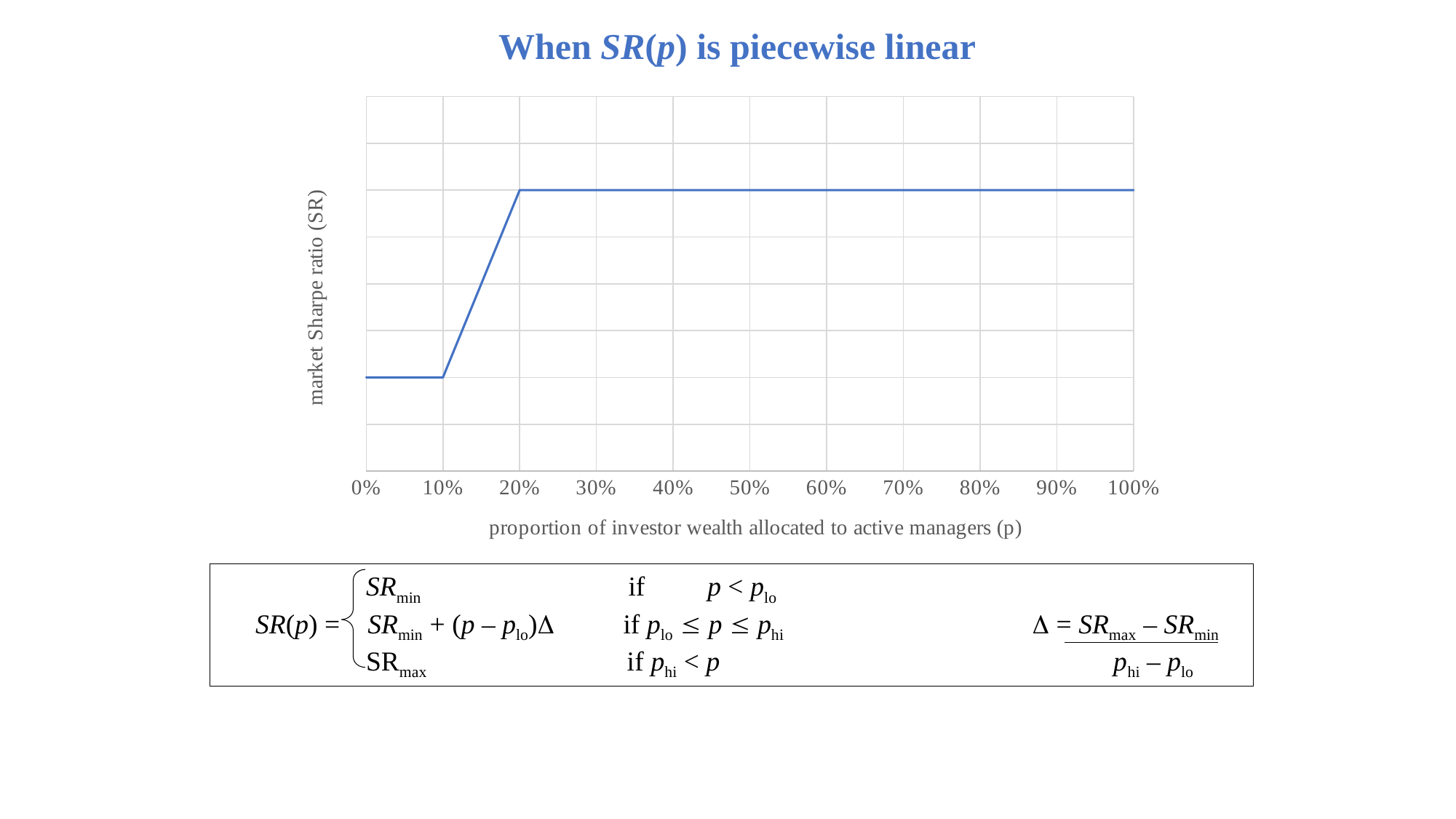
Between 10% and 20% on the x axis, does the line rise, fall, or stay flat? rise At which x-axis tick does the line begin to rise from its minimum level? 10% Is the market Sharpe ratio higher at p = 50% or at p = 5%? 50% Between 0% and 10% on the x axis, does the line rise, fall, or stay flat? stay flat What kind of chart is shown on the slide? line chart Between 20% and 100% on the x axis, does the line rise, fall, or stay flat? stay flat Is the market Sharpe ratio higher at p = 0% or at p = 100%? 100% What is the label on the x axis of the chart? proportion of investor wealth allocated to active managers (p) At which x-axis tick does the line reach its maximum level for the first time? 20% What colour is the plotted line? blue What is the title of the slide's chart? When SR(p) is piecewise linear How many tick labels are shown on the x axis? 11